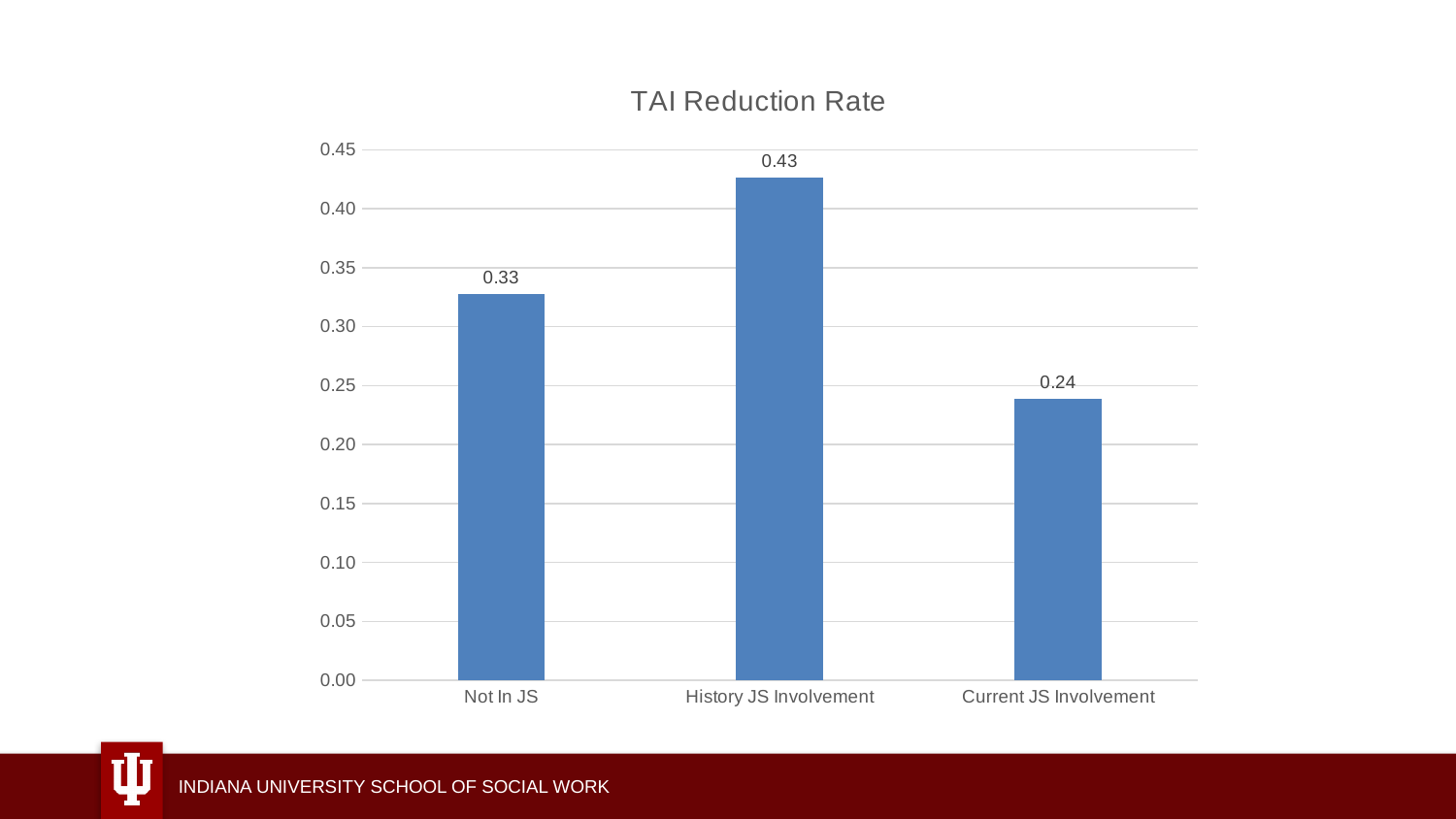
What is the difference between the TAI reduction rates for Not In JS and Current JS Involvement? 0.09 Is the TAI reduction rate for History JS Involvement greater or less than 0.40? greater What is the TAI reduction rate for Not In JS? 0.33 Which has a higher TAI reduction rate, Not In JS or Current JS Involvement? Not In JS What is the title of the chart? TAI Reduction Rate Which category has the lowest TAI reduction rate? Current JS Involvement What is the TAI reduction rate for Current JS Involvement? 0.24 Which category has the highest TAI reduction rate? History JS Involvement What is the difference between the TAI reduction rates for History JS Involvement and Current JS Involvement? 0.19 What kind of chart is shown on the slide? Bar chart What is the TAI reduction rate for History JS Involvement? 0.43 How many categories are shown in the chart? 3